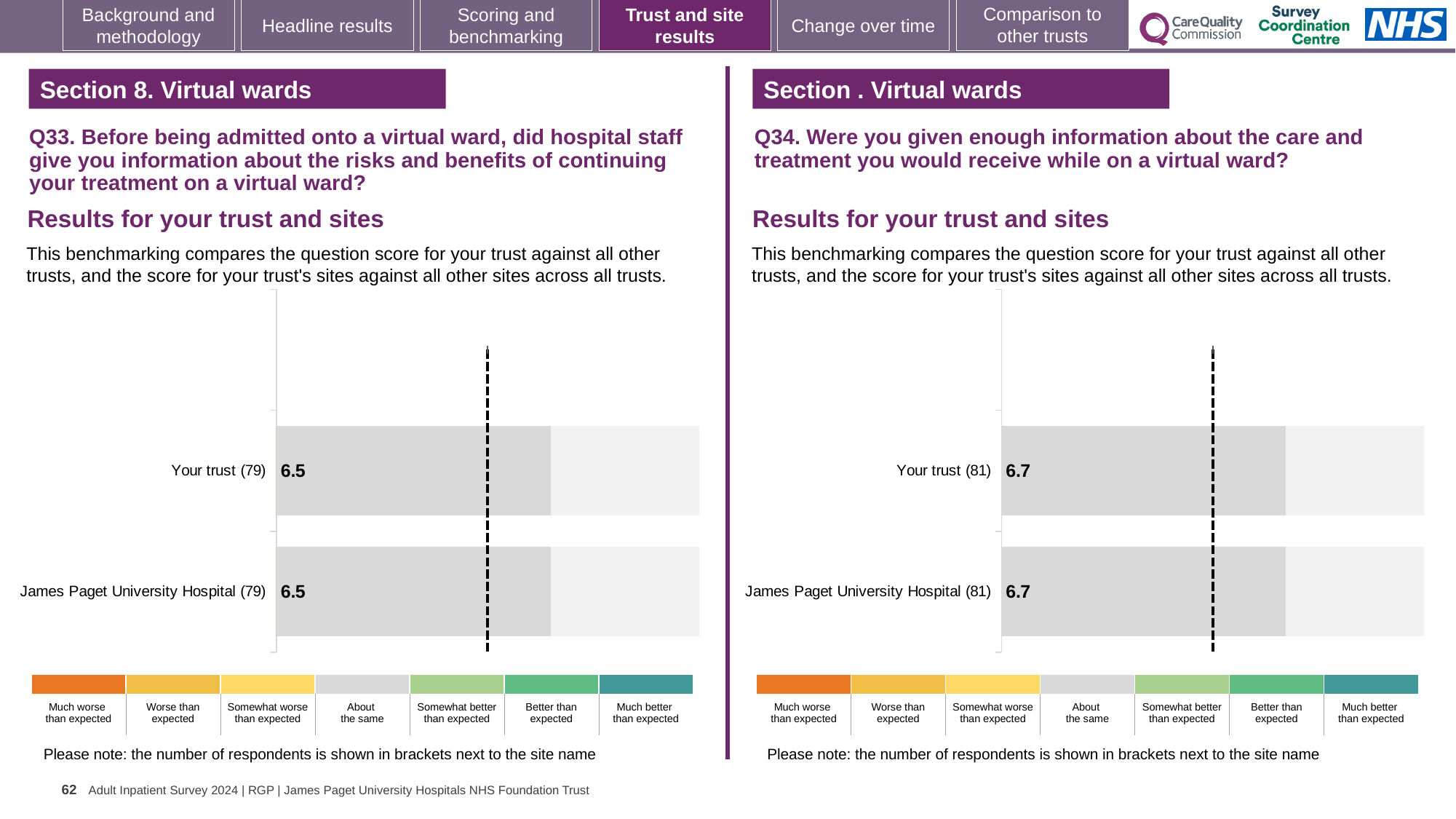
In the Q34 chart on the right, what is the score for James Paget University Hospital? 6.7 What kind of chart is used in the Q33 chart on the left? Bar chart In the Q34 chart on the right, what is the difference between the score for Your trust and the score for James Paget University Hospital? 0.0 In the Q33 chart on the left, what is the score for James Paget University Hospital? 6.5 In the Q34 chart on the right, which benchmark category does the colour key label as the middle (grey) band? About the same In the Q34 chart on the right, what is the score for Your trust? 6.7 In the Q33 chart on the left, what is the score for Your trust? 6.5 How many bars are plotted in the Q33 chart on the left? 2 In the Q33 chart on the left, how many respondents are shown in brackets for Your trust? 79 In the Q34 chart on the right, how many respondents are shown in brackets for James Paget University Hospital? 81 In the Q33 chart on the left, what is the difference between the score for Your trust and the score for James Paget University Hospital? 0.0 How many bars are plotted in the Q34 chart on the right? 2